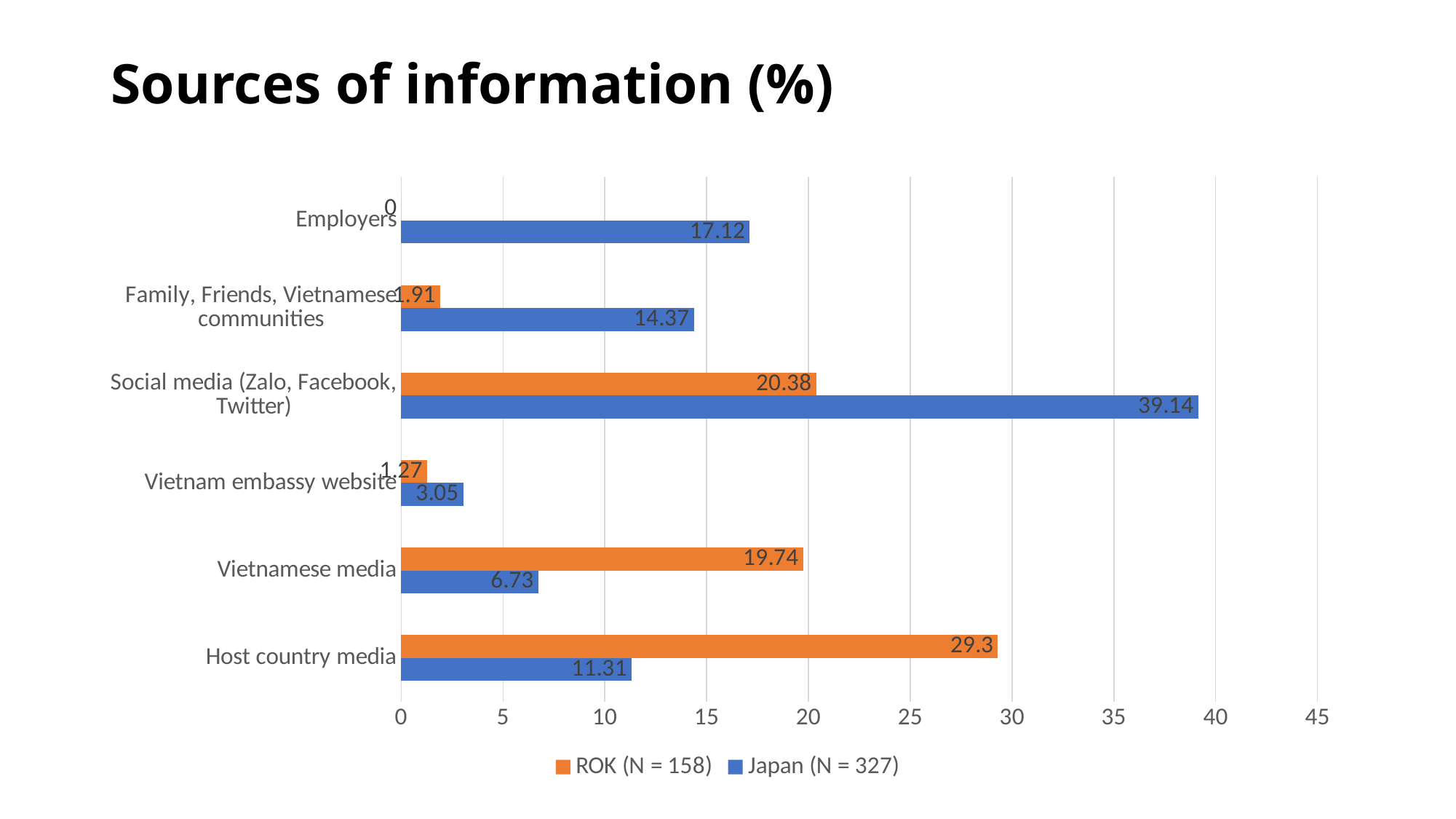
What is the value for Japan (N = 327) for Social media (Zalo, Facebook, Twitter)? 39.14 What is the value for ROK (N = 158) for Host country media? 29.3 What is the title of the chart? Sources of information (%) Which category has the highest value for Japan (N = 327)? Social media (Zalo, Facebook, Twitter) Is the Japan (N = 327) value for Employers greater or less than 15? greater What is the difference between the Japan (N = 327) and ROK (N = 158) values for Social media (Zalo, Facebook, Twitter)? 18.76 For Vietnamese media, which series has the larger value, ROK (N = 158) or Japan (N = 327)? ROK (N = 158) Which category has the lowest value for ROK (N = 158)? Employers What is the value for ROK (N = 158) for Employers? 0 How many categories are shown on the chart? 6 What kind of chart is shown on the slide? Bar chart How many series does the legend list? 2